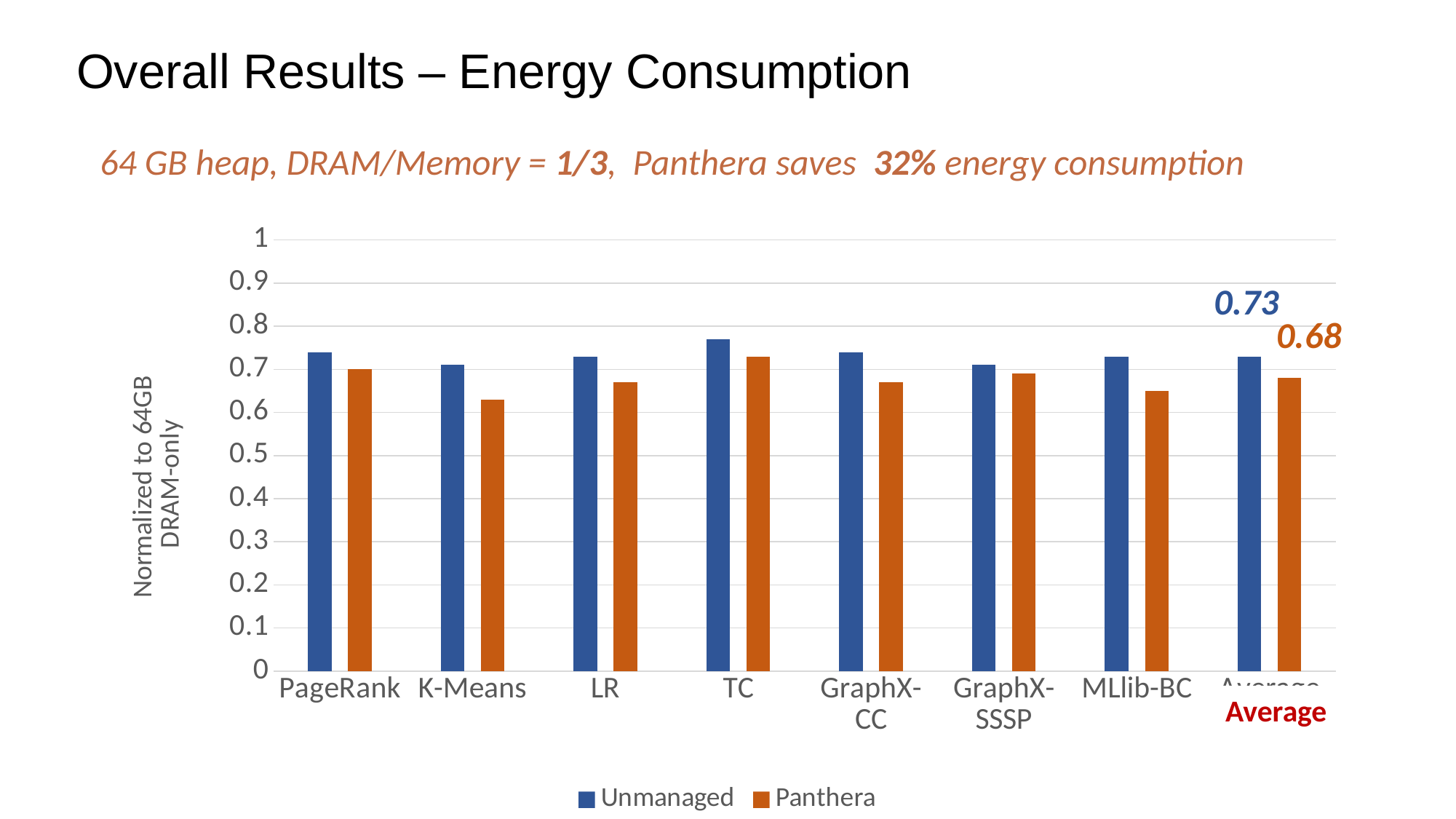
For PageRank, which series has the larger value, Unmanaged or Panthera? Unmanaged What is the Panthera value for Average? 0.68 Which category has the highest Unmanaged bar? TC What is the Unmanaged value for Average? 0.73 What kind of chart is shown on the slide? Bar chart For Average, which series has the larger value, Unmanaged or Panthera? Unmanaged How many series does the legend list? 2 Which is larger, the Panthera value for TC or the Panthera value for K-Means? TC Is the Unmanaged value for TC greater or less than 0.7? greater What is the difference between the Unmanaged and Panthera values for Average? 0.05 How many categories are shown on the x axis? 8 Is the Panthera value for K-Means greater or less than 0.7? less